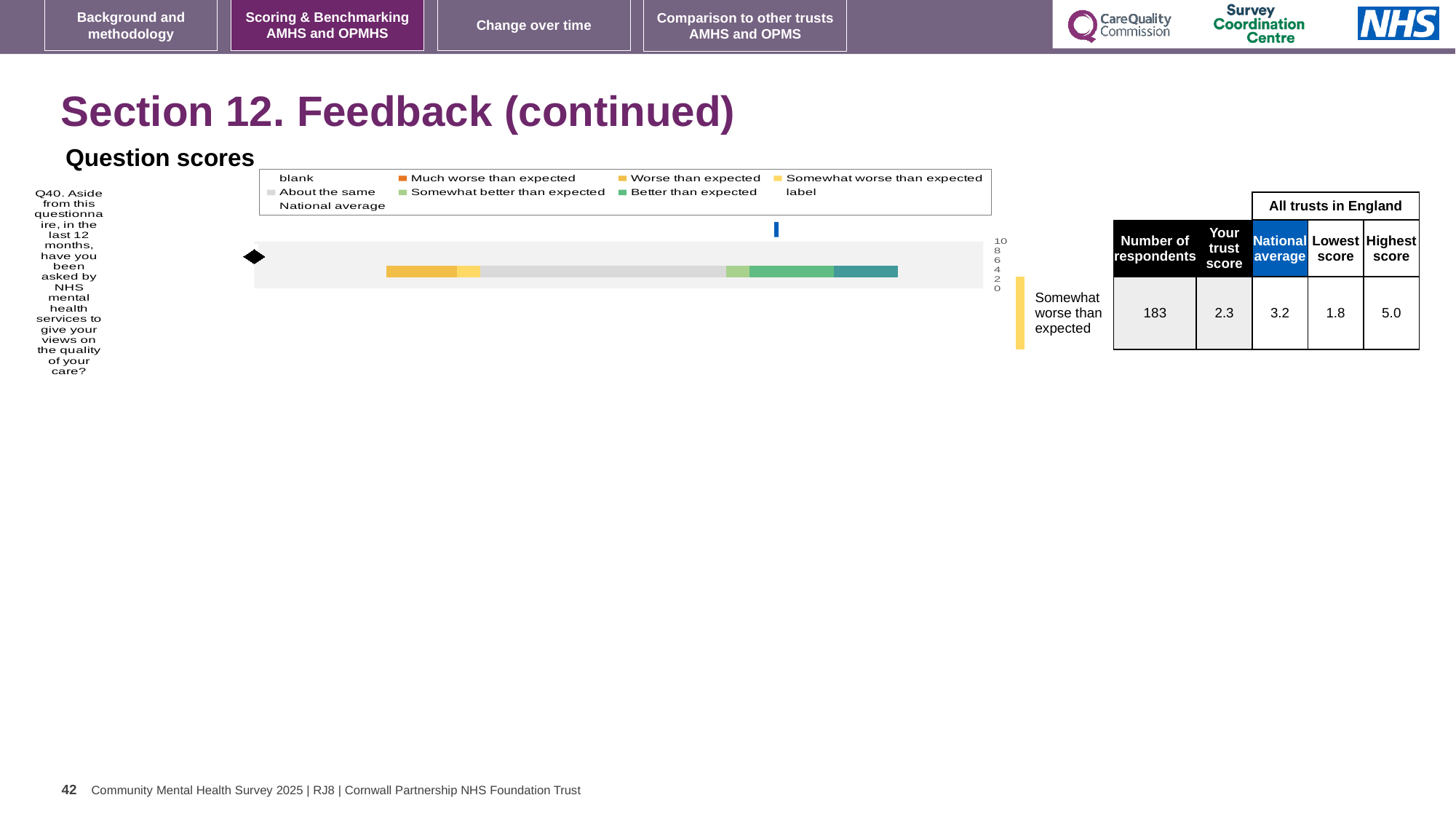
In the table beside the chart, what is the number of respondents for Q40? 183 In the table beside the chart, what is the national average for Q40? 3.2 How many questions (categories) are plotted in the chart? 1 In the table beside the chart, what is the lowest score among all trusts in England for Q40? 1.8 What is the difference between the national average and the trust's score for Q40? 0.9 What kind of chart is shown on the slide? bar chart Which is larger for Q40, the trust's score or the national average? national average In the table beside the chart, what is the trust's score for Q40? 2.3 In the table beside the chart, what is the highest score among all trusts in England for Q40? 5.0 What benchmark category is the trust's Q40 score labelled as next to the chart? Somewhat worse than expected What is the highest value shown on the chart's axis? 10 Which question number is plotted in the chart? Q40